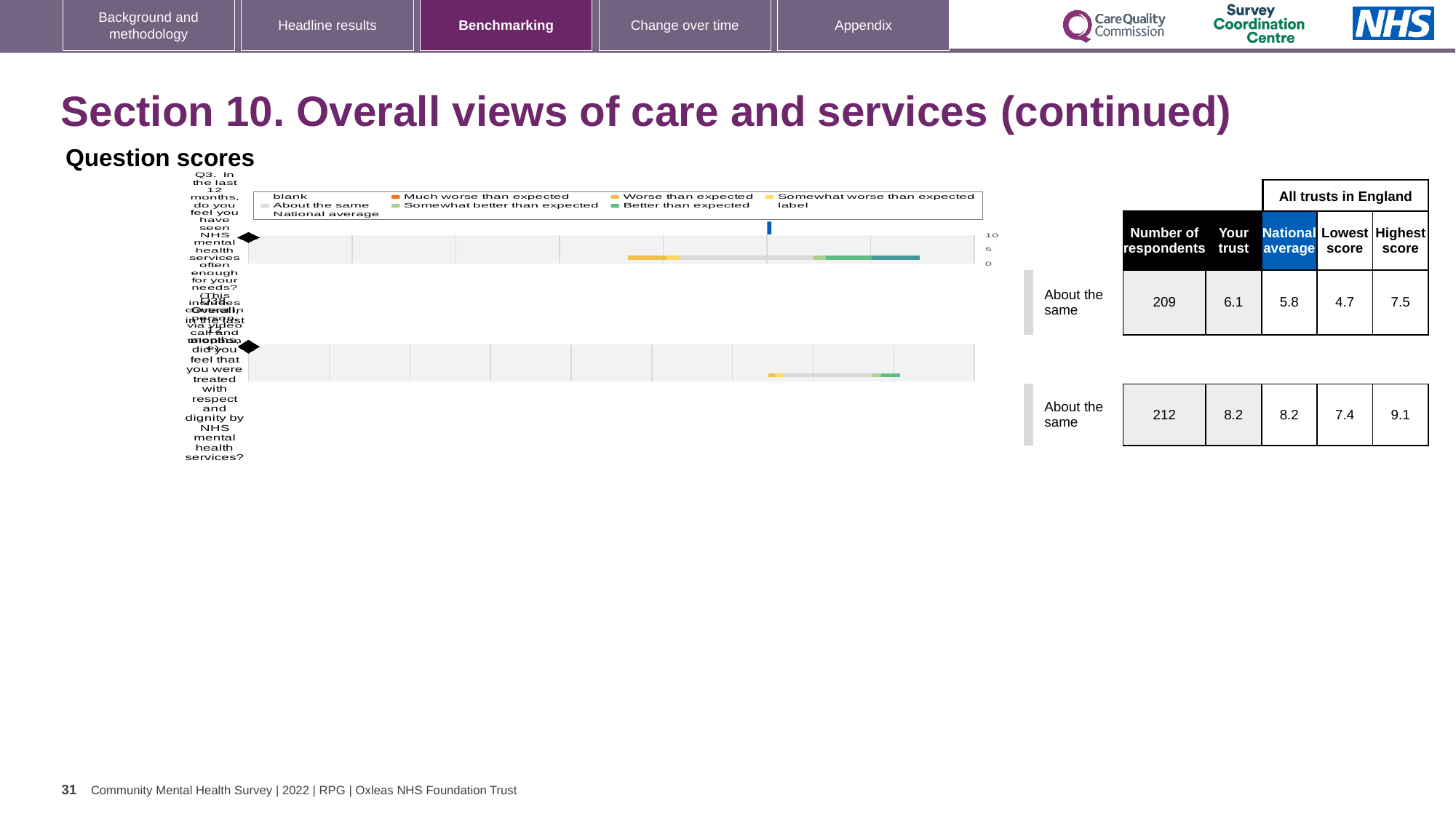
For the Q3 chart, how much higher is the 'Your trust' score than the national average? 0.3 What kind of chart is used to show the question scores on this slide? bar chart For the Q34 chart (treated with respect and dignity), what is the highest score among all trusts in England? 9.1 Which question has the higher 'Your trust' score, Q3 or Q34? Q34 For the Q34 chart (treated with respect and dignity), what is the 'Your trust' score? 8.2 For the Q3 chart (seen NHS mental health services often enough), what is the national average score? 5.8 For the Q3 chart, what is the difference between the highest score (7.5) and the lowest score (4.7) among all trusts in England? 2.8 For the Q3 chart (seen NHS mental health services often enough), what is the 'Your trust' score? 6.1 How many question score charts are shown on the slide? 2 What benchmark category label is shown next to both the Q3 and Q34 charts? About the same For the Q3 chart (seen NHS mental health services often enough), what is the number of respondents shown in the table? 209 For the Q34 chart (treated with respect and dignity), what is the lowest score among all trusts in England? 7.4